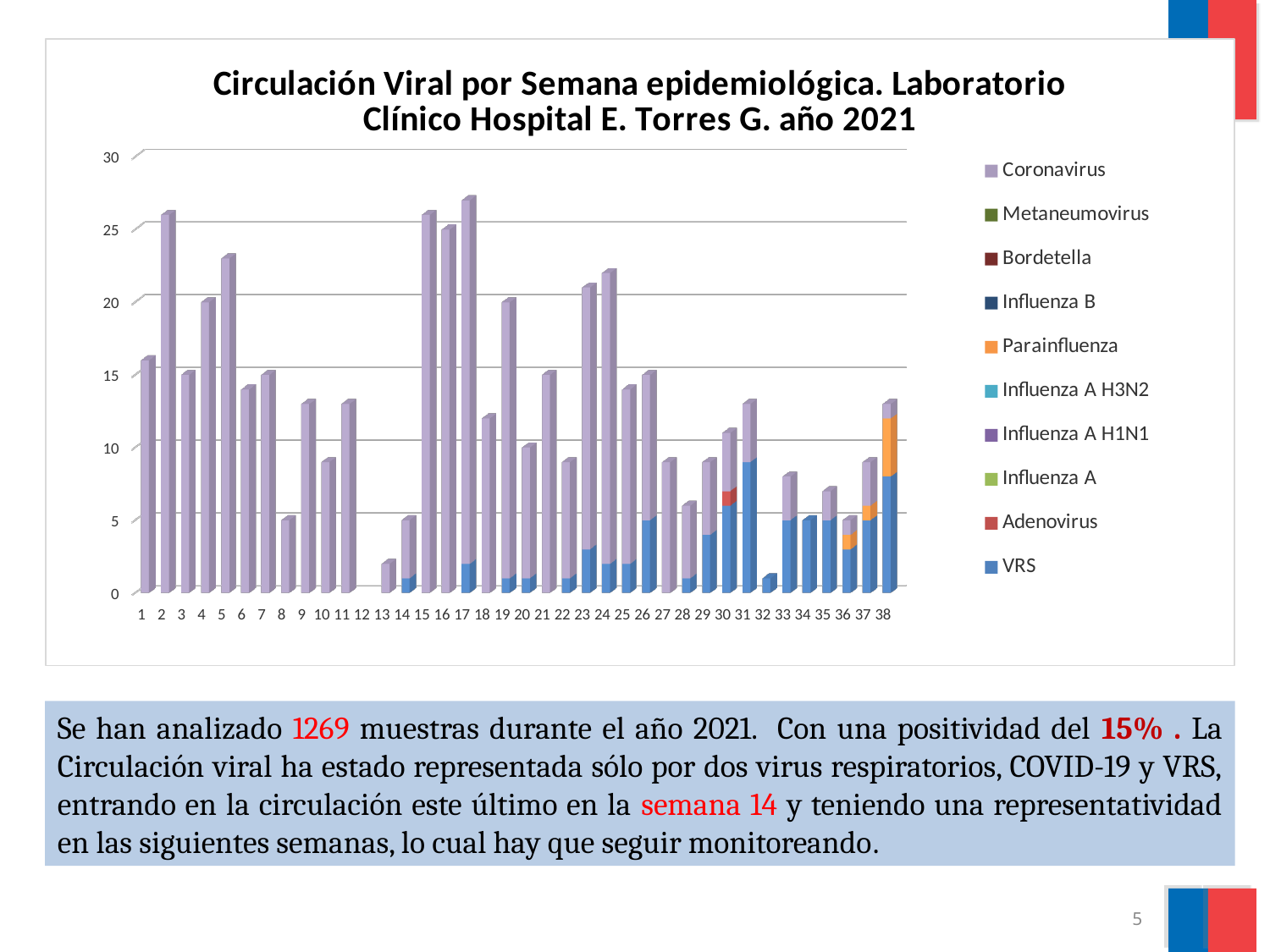
How many epidemiological weeks are shown on the x axis? 38 Which series is listed last in the legend? VRS Is the total value for week 13 greater or less than 5? less Is the total value for week 38 greater or less than 10? greater Is the total value for week 24 greater or less than 20? greater How many series does the legend list? 10 What kind of chart is shown on the slide? Stacked bar chart Which series is listed first in the legend? Coronavirus Which week has the taller bar, week 1 or week 2? Week 2 Which week has the taller bar, week 5 or week 6? Week 5